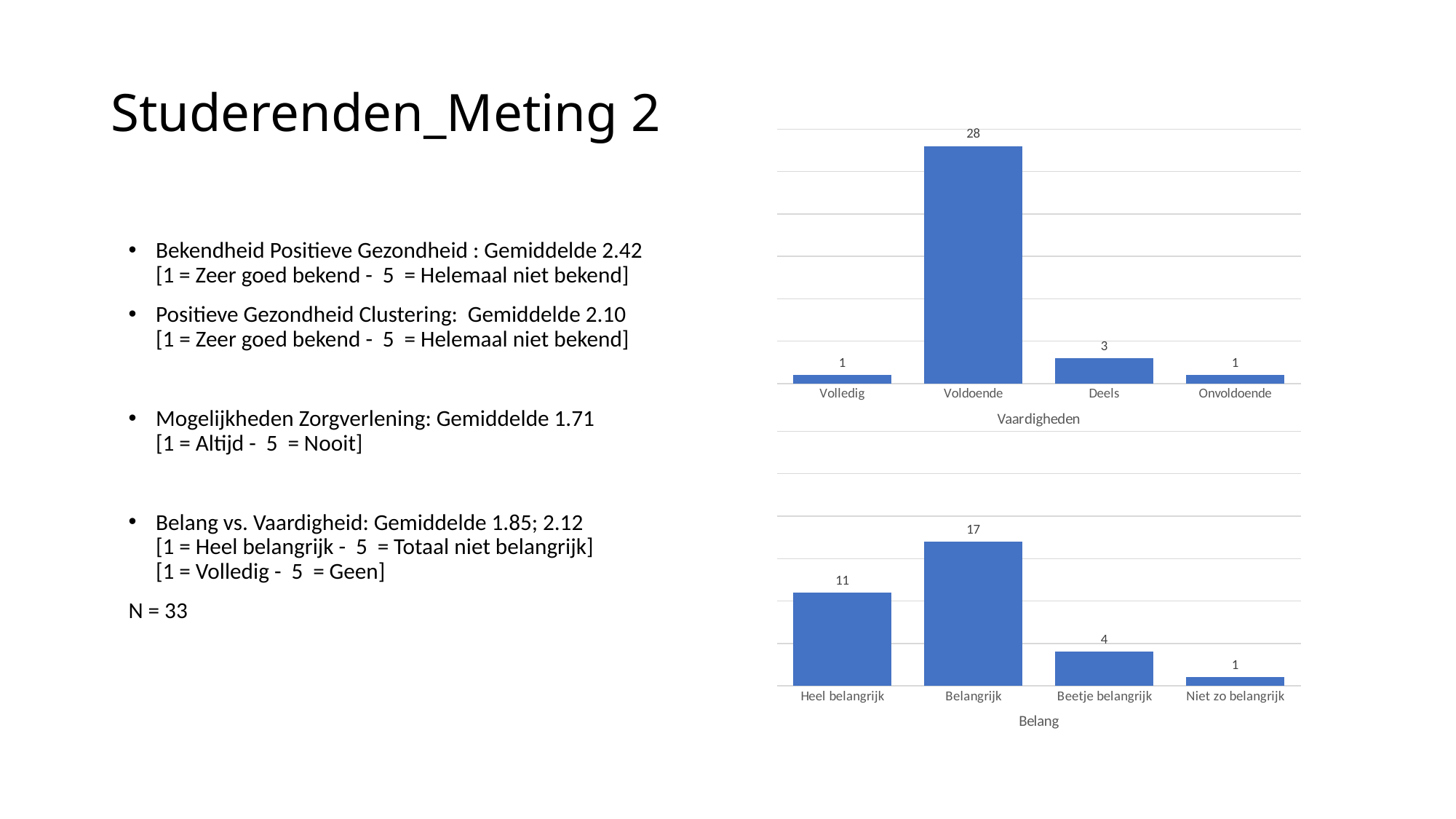
In the Vaardigheden chart, which category has the highest value? Voldoende In the Vaardigheden chart, what is the difference between Voldoende and Deels? 25 What kind of chart is the Belang chart? Bar chart In the Belang chart, what is the difference between Belangrijk and Heel belangrijk? 6 In the Belang chart, do the values rise or fall from Belangrijk to Niet zo belangrijk? Fall In the Vaardigheden chart, what is the value for Deels? 3 In the Vaardigheden chart, how many categories are shown? 4 In the Belang chart, which is larger: Heel belangrijk or Belangrijk? Belangrijk In the Belang chart, which category has the lowest value? Niet zo belangrijk In the Belang chart, what is the value for Heel belangrijk? 11 In the Belang chart, what is the value for Beetje belangrijk? 4 In the Vaardigheden chart, what is the value for Voldoende? 28